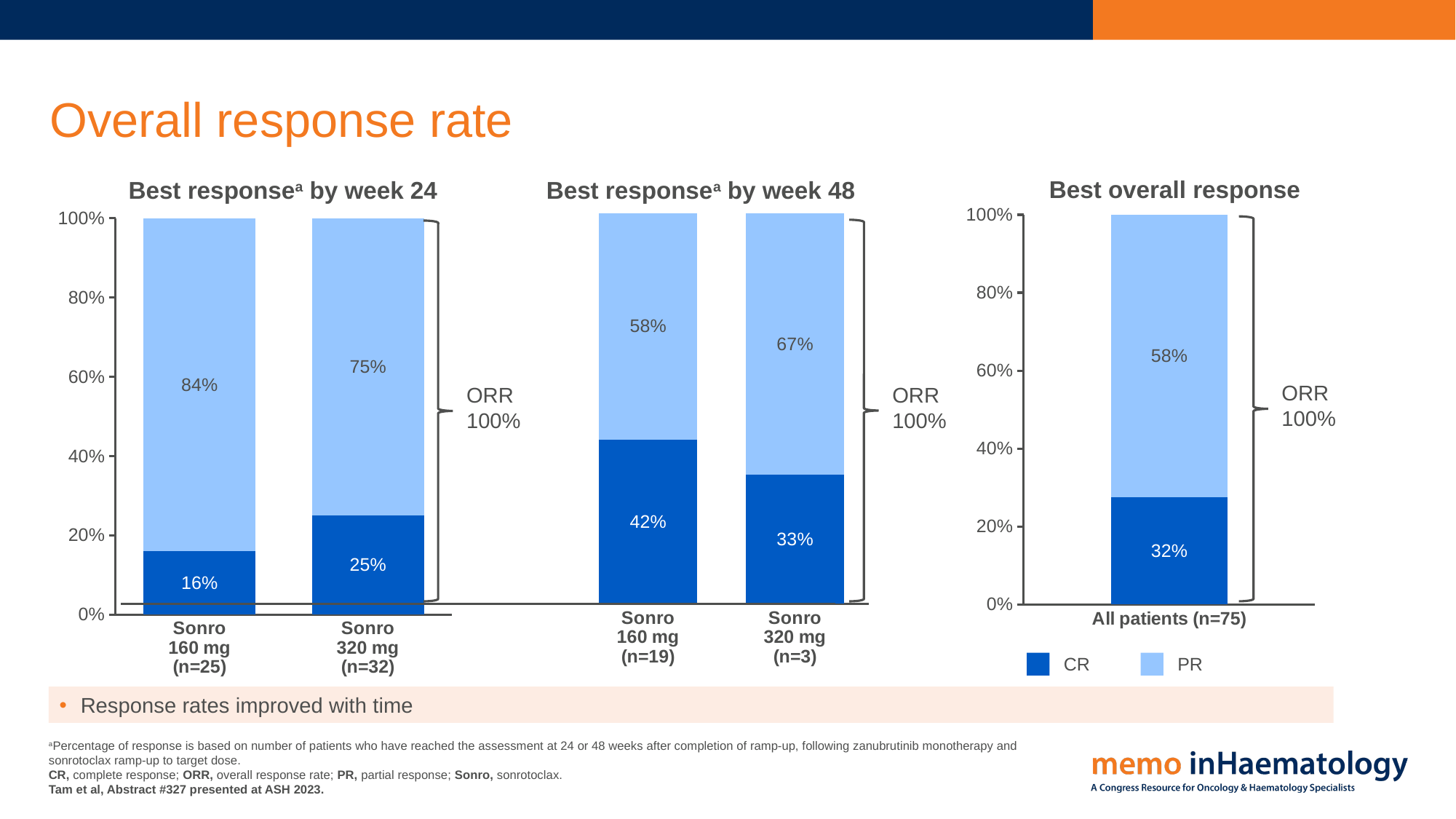
In the 'Best response by week 48' chart, which dose group has the lower PR value? Sonro 160 mg (n=19) In the 'Best response by week 24' chart, what is the CR value for Sonro 160 mg (n=25)? 16% In the 'Best response by week 48' chart, what is the PR value for Sonro 320 mg (n=3)? 67% In the 'Best response by week 24' chart, what is the PR value for Sonro 320 mg (n=32)? 75% How many series does the legend list? 2 In the 'Best response by week 48' chart, what is the CR value for Sonro 160 mg (n=19)? 42% What kind of chart is 'Best response by week 48'? Stacked bar chart In the 'Best response by week 24' chart, which dose group has the higher CR value? Sonro 320 mg (n=32) In the 'Best overall response' chart, what is the CR value for All patients (n=75)? 32% In the 'Best response by week 24' chart, what is the difference between the PR values of Sonro 160 mg and Sonro 320 mg? 9% In the 'Best overall response' chart, what is the total of the stacked bar for All patients (n=75)? 100% How many categories are shown in the 'Best response by week 24' chart? 2